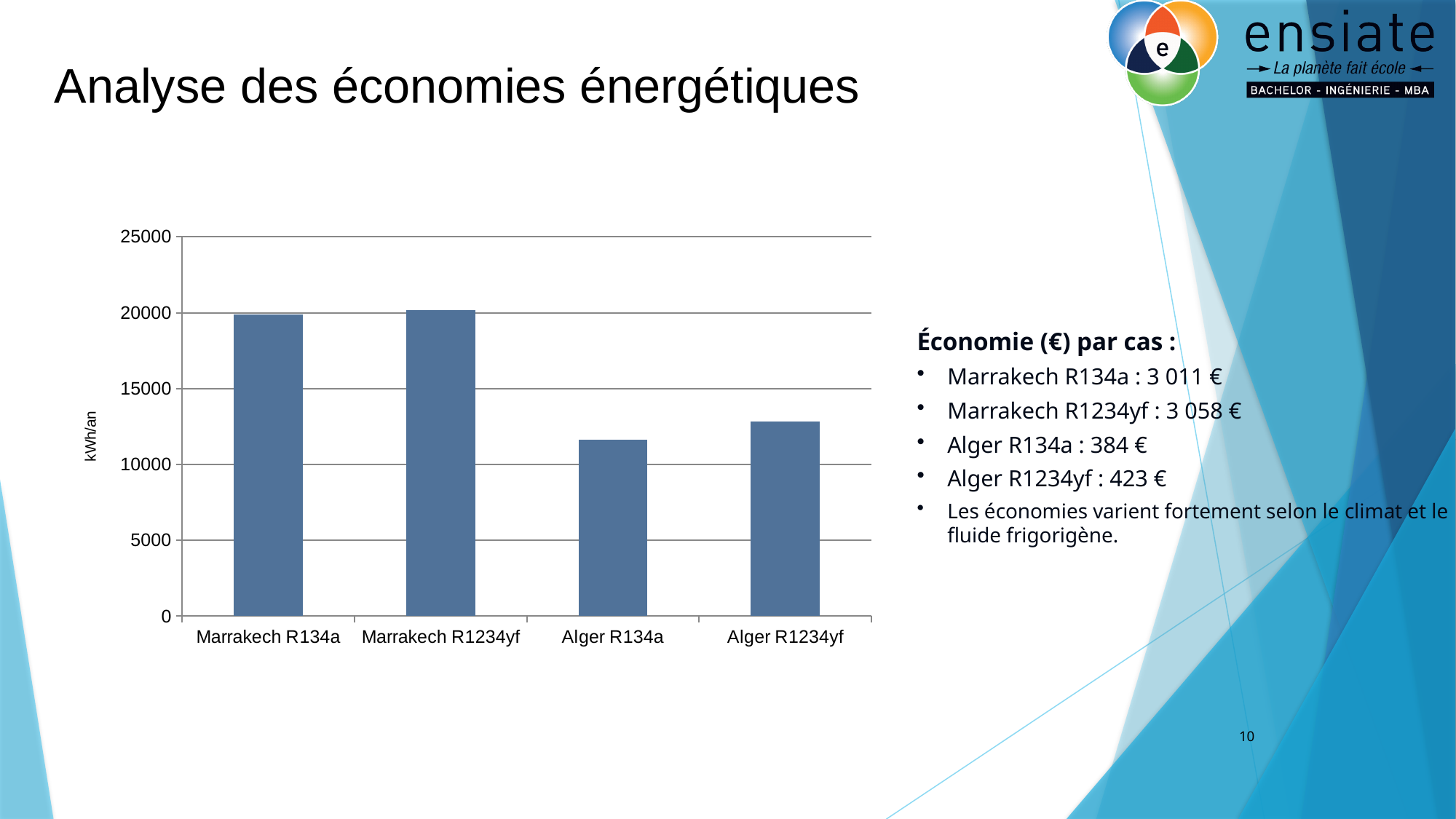
Is the value for Alger R1234yf greater or less than 15000? less Is the value for Marrakech R134a greater or less than 15000? greater Is the value for Alger R134a greater or less than 10000? greater What is the highest value shown on the vertical axis of the chart? 25000 What kind of chart is shown on the slide? bar chart Which category has the lowest value on the chart? Alger R134a What is the label on the vertical axis of the chart? kWh/an Which is larger, the value for Marrakech R134a or the value for Alger R134a? Marrakech R134a How many categories are plotted on the chart? 4 Which is larger, the value for Alger R1234yf or the value for Alger R134a? Alger R1234yf